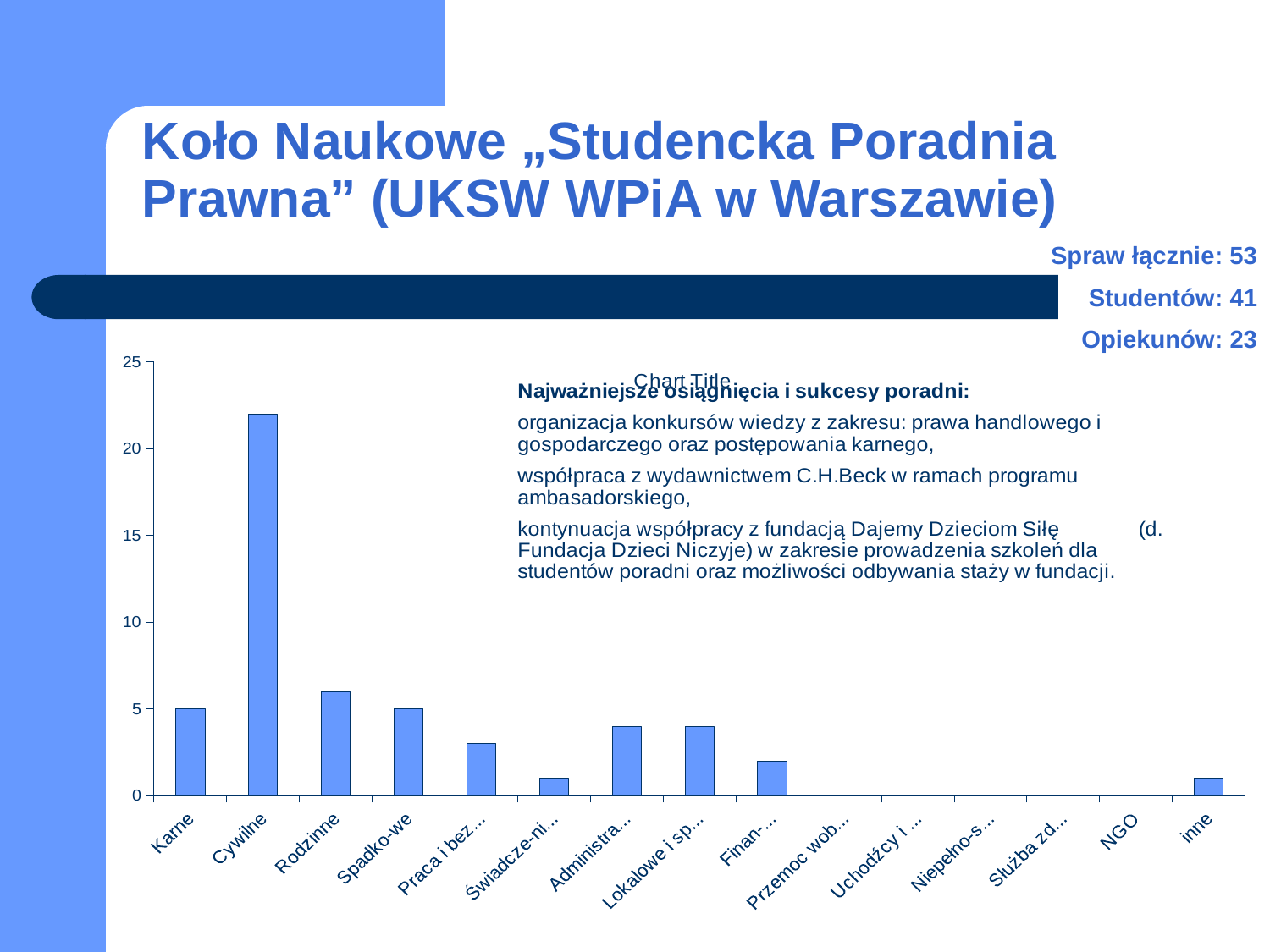
What is the value for Karne? 5 What is the title shown on the chart? Chart Title Which category has the highest value in the chart? Cywilne Is the value for Finan-... greater or less than 5? less What kind of chart is shown on the slide? bar chart How many categories are shown on the x axis of the chart? 15 Is the value for Rodzinne greater or less than 5? greater Which is larger, the value for Cywilne or the value for Rodzinne? Cywilne What is the value for Spadko-we? 5 Is the value for Praca i bez... greater or less than 5? less Which is larger, the value for Karne or the value for Finan-...? Karne